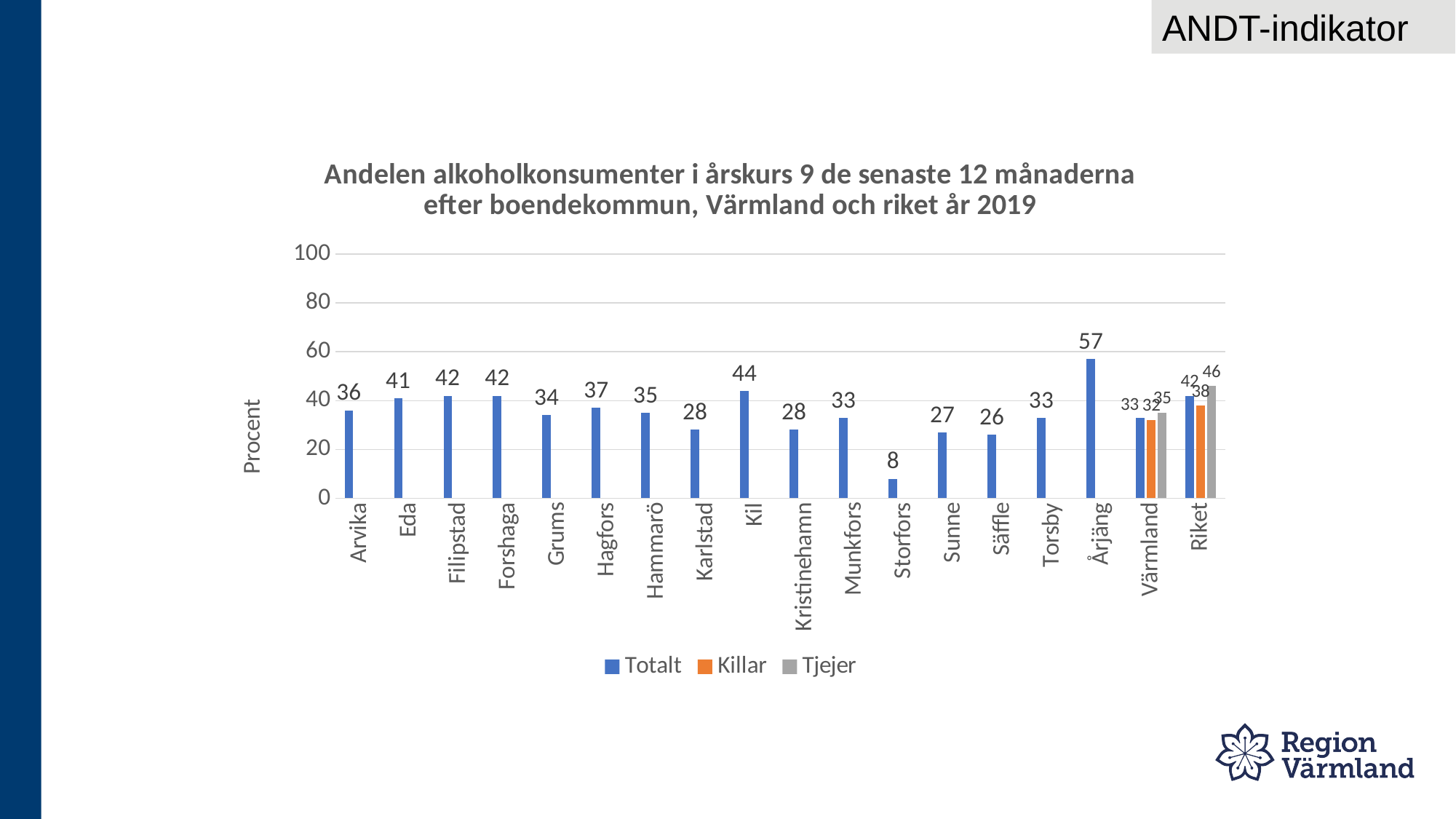
Is the Totalt value for Karlstad greater or less than 40? less What is the Tjejer value for Riket? 46 What is the difference between the Totalt values for Årjäng and Storfors? 49 Which category has the highest Totalt value? Årjäng Which category has the lowest Totalt value? Storfors How many categories are shown on the x axis? 18 What is the label on the vertical axis? Procent What is the Killar value for Värmland? 32 What kind of chart is shown on the slide? bar chart How many series does the legend list? 3 Which has a higher Totalt value, Eda or Grums? Eda What is the Totalt value for Kil? 44